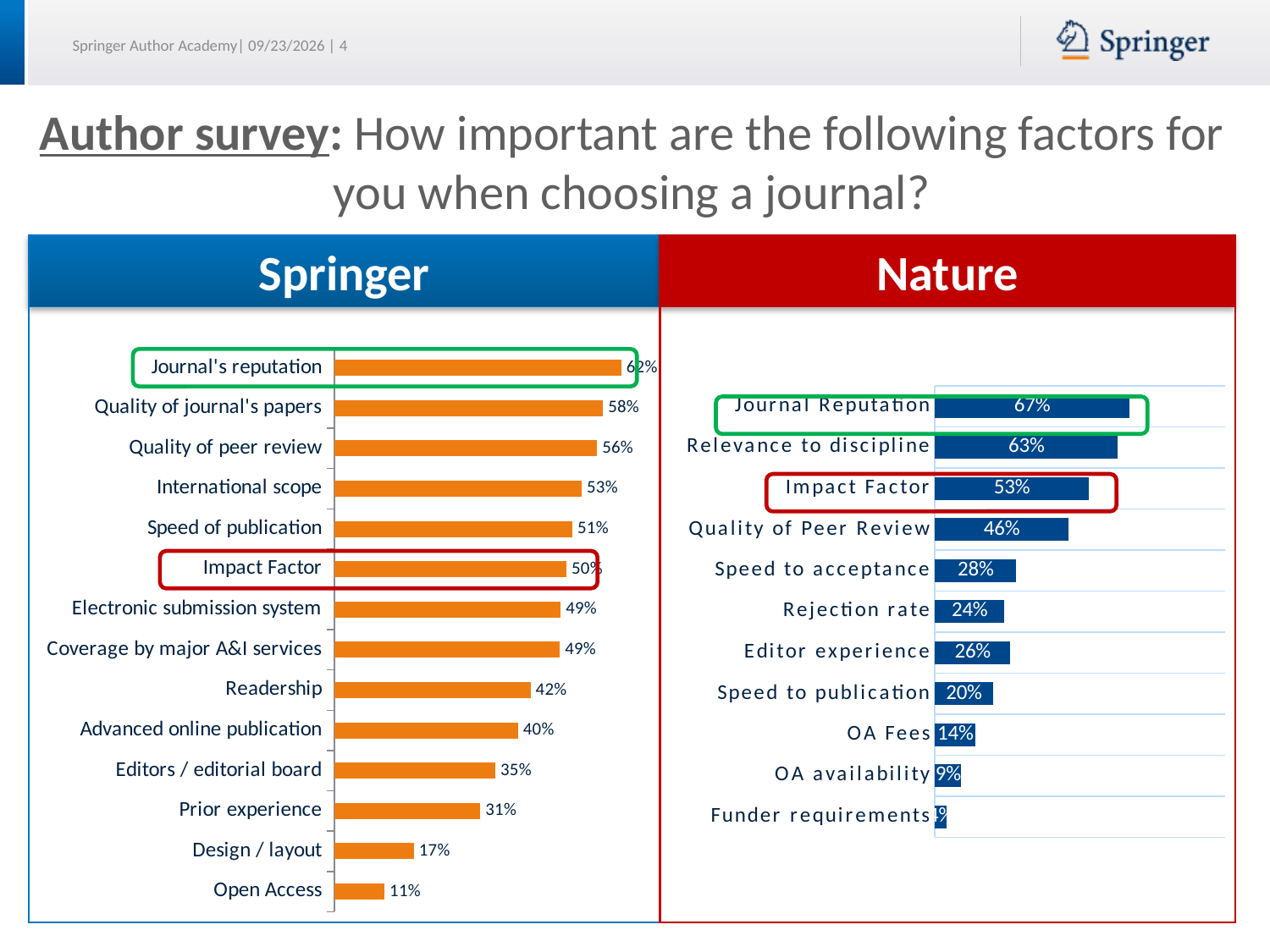
In the Springer chart, what percentage is shown for Quality of peer review? 56% How many factors are listed in the Springer chart? 14 How many factors are listed in the Nature chart? 11 In the Springer chart, which is larger: Prior experience or Editors / editorial board? Editors / editorial board What colour are the bars in the Nature chart? Blue In the Nature chart, what is the difference between Journal Reputation and Impact Factor? 14% In the Springer chart, what is the difference between Readership and Design / layout? 25% In the Nature chart, which factor has the highest value? Journal Reputation In the Nature chart, which is larger: Speed to acceptance or Speed to publication? Speed to acceptance What type of chart is used in the Springer panel? Bar chart In the Springer chart, which factor has the lowest value? Open Access In the Nature chart, what percentage is shown for Relevance to discipline? 63%